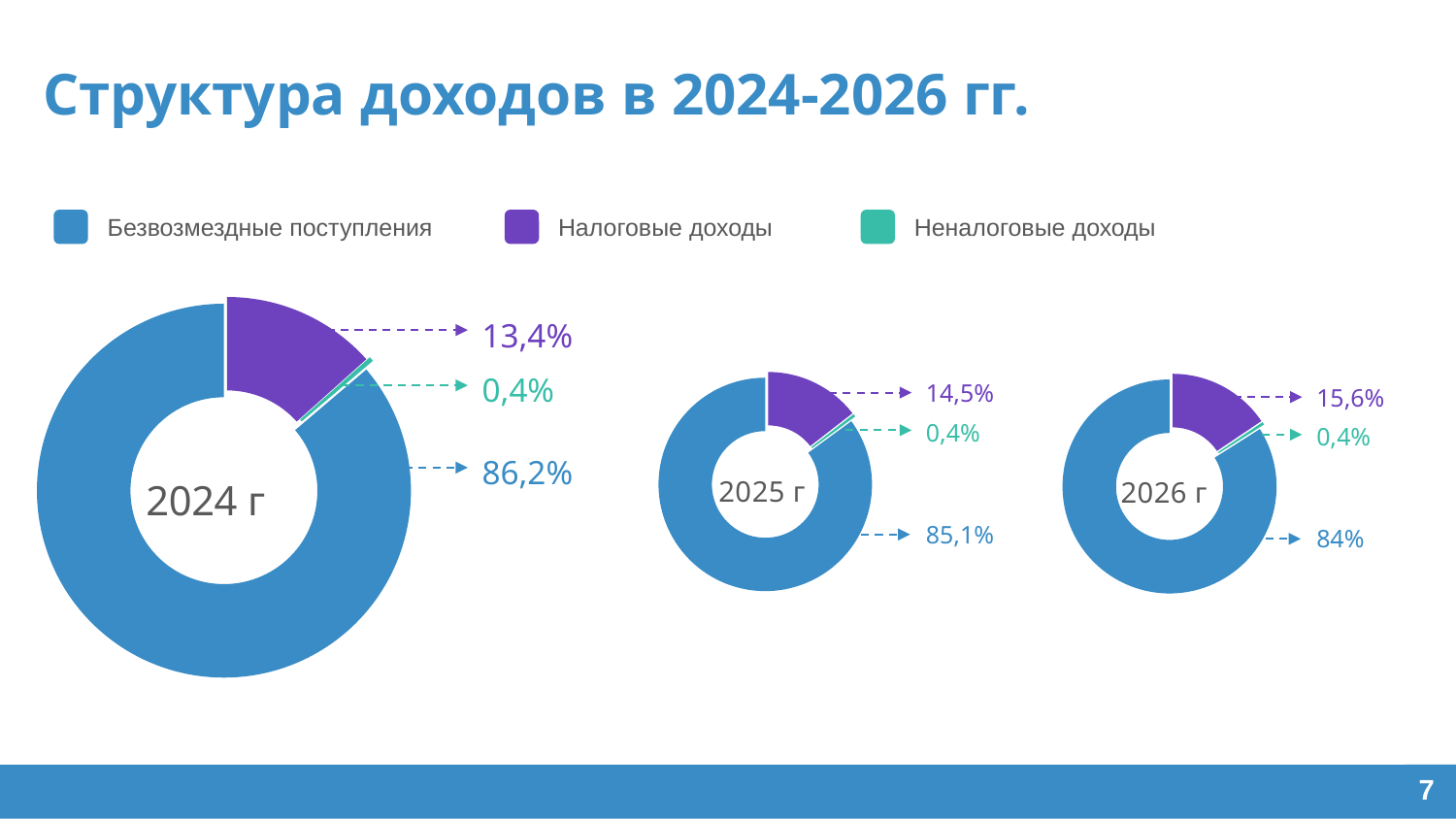
In the 2026 г chart, what share is shown for Неналоговые доходы? 0,4% How does the share of Налоговые доходы change from 2024 г to 2026 г? It rises In the 2025 г chart, what share is shown for Налоговые доходы? 14,5% Which is larger: the share of Налоговые доходы in the 2024 г chart or in the 2026 г chart? 2026 г What colour represents Неналоговые доходы in the legend? Teal (green) In the 2024 г chart, which category has the largest share? Безвозмездные поступления What kind of chart is used for 2025 г? Donut (pie) chart In the 2025 г chart, which category has the smallest share? Неналоговые доходы In the 2026 г chart, what is the difference between the shares of Налоговые доходы and Неналоговые доходы? 15,2% In the 2024 г chart, what share is shown for Безвозмездные поступления? 86,2% In the 2026 г chart, what share is shown for Безвозмездные поступления? 84% How many categories does the legend list? 3